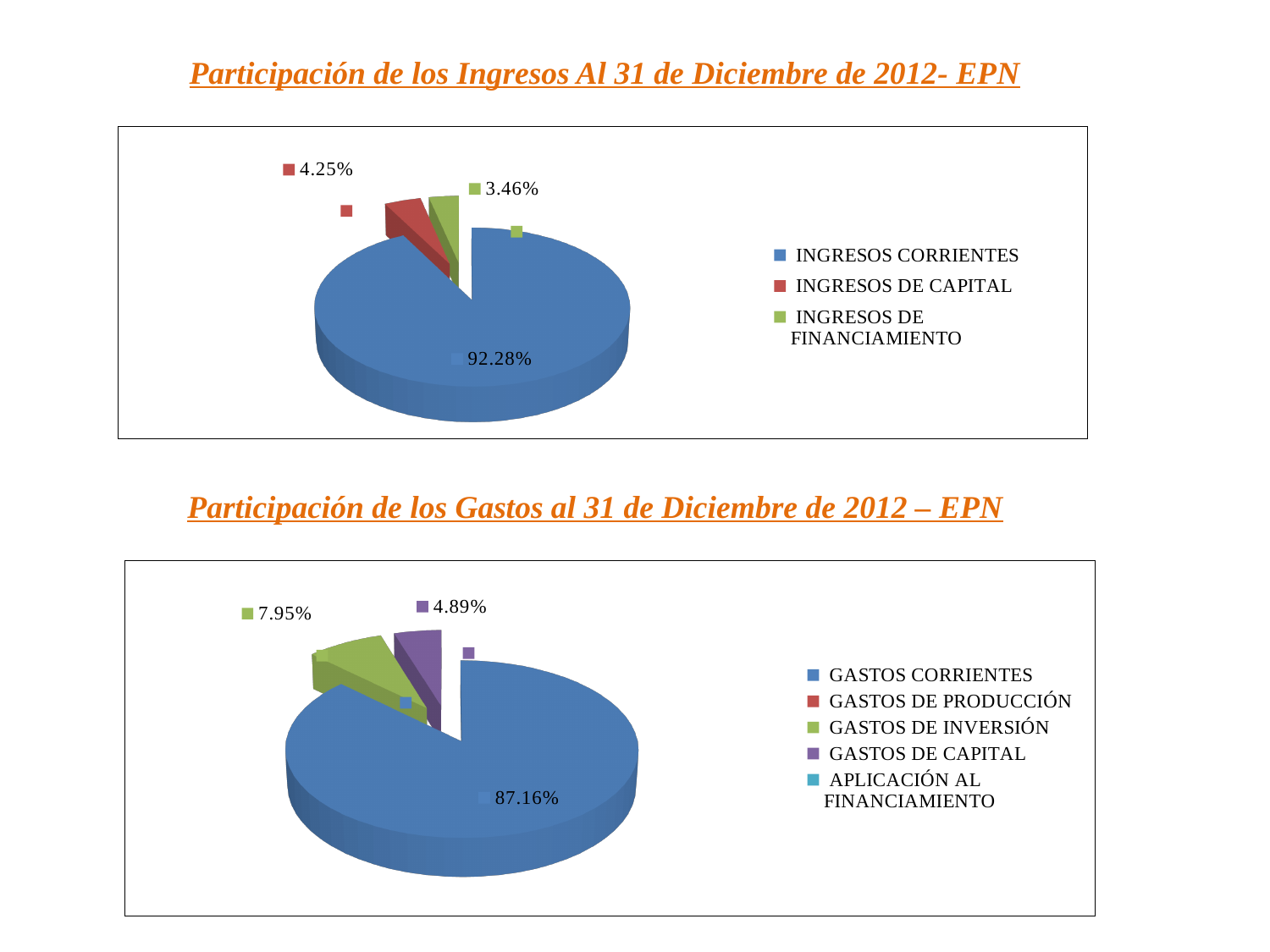
What type of chart is the top chart (Participación de los Ingresos)? Pie chart In the bottom chart (Participación de los Gastos), which is larger, GASTOS DE INVERSIÓN or GASTOS DE CAPITAL? GASTOS DE INVERSIÓN How many categories does the legend of the bottom chart (Participación de los Gastos) list? 5 In the top chart (Participación de los Ingresos), which category has the largest share? INGRESOS CORRIENTES In the top chart (Participación de los Ingresos), which category has the smallest share? INGRESOS DE FINANCIAMIENTO In the top chart (Participación de los Ingresos), what is the difference in percentage points between INGRESOS DE CAPITAL and INGRESOS DE FINANCIAMIENTO? 0.79 In the top chart (Participación de los Ingresos), what share does INGRESOS DE FINANCIAMIENTO have? 3.46% In the top chart (Participación de los Ingresos), what share does INGRESOS CORRIENTES have? 92.28% In the bottom chart (Participación de los Gastos), what share does GASTOS DE INVERSIÓN have? 7.95% In the bottom chart (Participación de los Gastos), what share does GASTOS DE CAPITAL have? 4.89% In the bottom chart (Participación de los Gastos), what share does GASTOS CORRIENTES have? 87.16% In the top chart (Participación de los Ingresos), what share does INGRESOS DE CAPITAL have? 4.25%